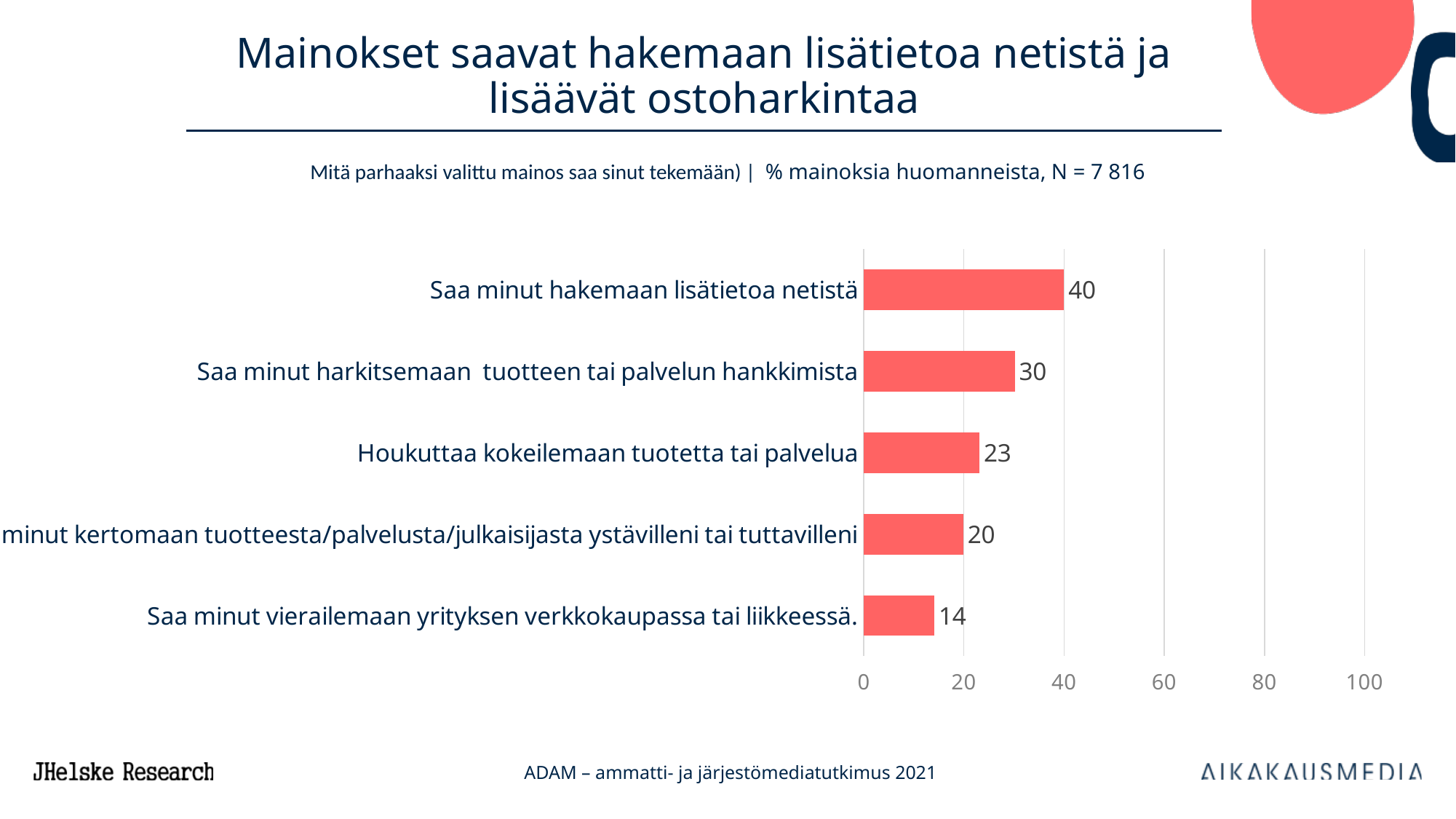
What is the value for "Houkuttaa kokeilemaan tuotetta tai palvelua"? 23 Which category has the highest value? Saa minut hakemaan lisätietoa netistä What is the value for "Saa minut hakemaan lisätietoa netistä"? 40 How many categories are shown in the chart? 5 Which is larger: the value for "Houkuttaa kokeilemaan tuotetta tai palvelua" or the value for "Saa minut vierailemaan yrityksen verkkokaupassa tai liikkeessä."? Houkuttaa kokeilemaan tuotetta tai palvelua Is the value for "Saa minut harkitsemaan tuotteen tai palvelun hankkimista" greater or less than 20? greater What colour are the bars in the chart? red What is the highest tick value shown on the horizontal axis? 100 Which category has the lowest value? Saa minut vierailemaan yrityksen verkkokaupassa tai liikkeessä. What is the difference between the values for "Saa minut hakemaan lisätietoa netistä" and "Saa minut harkitsemaan tuotteen tai palvelun hankkimista"? 10 What kind of chart is shown on the slide? bar chart What is the value for "Saa minut vierailemaan yrityksen verkkokaupassa tai liikkeessä."? 14